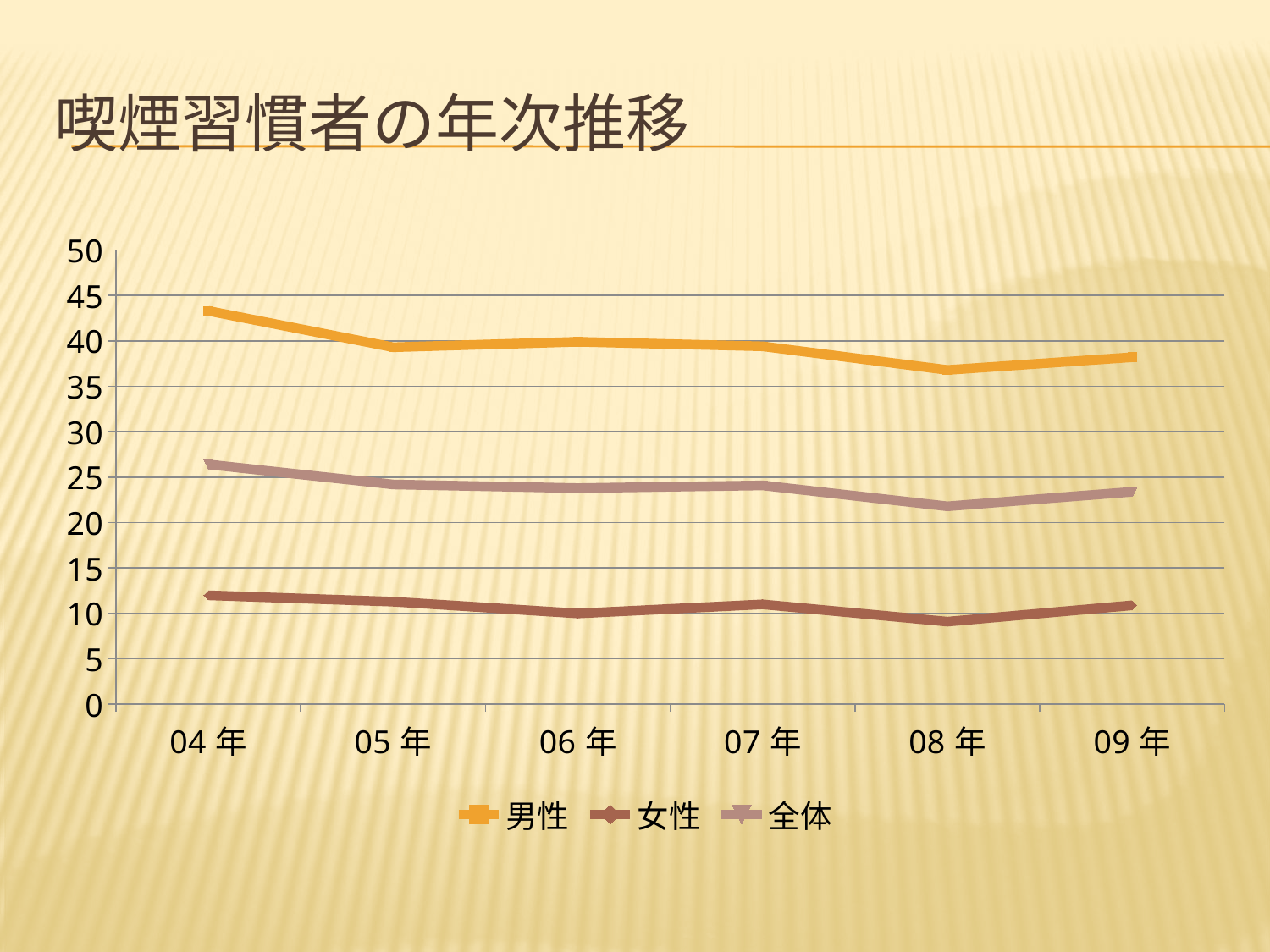
Is the value for 全体 in 08年 greater or less than 25? less Which series has the larger value in 09年, 女性 or 全体? 全体 In which year is the value for 男性 highest? 04年 In which year is the value for 男性 lowest? 08年 Is the value for 男性 in 04年 greater or less than 40? greater Which series is shown in orange in the legend? 男性 Is the value for 男性 in 08年 greater or less than 40? less What kind of chart is shown on the slide? line chart What is the title of the chart? 喫煙習慣者の年次推移 How many series does the legend list? 3 How many years are plotted along the x axis? 6 In which year is the value for 全体 highest? 04年